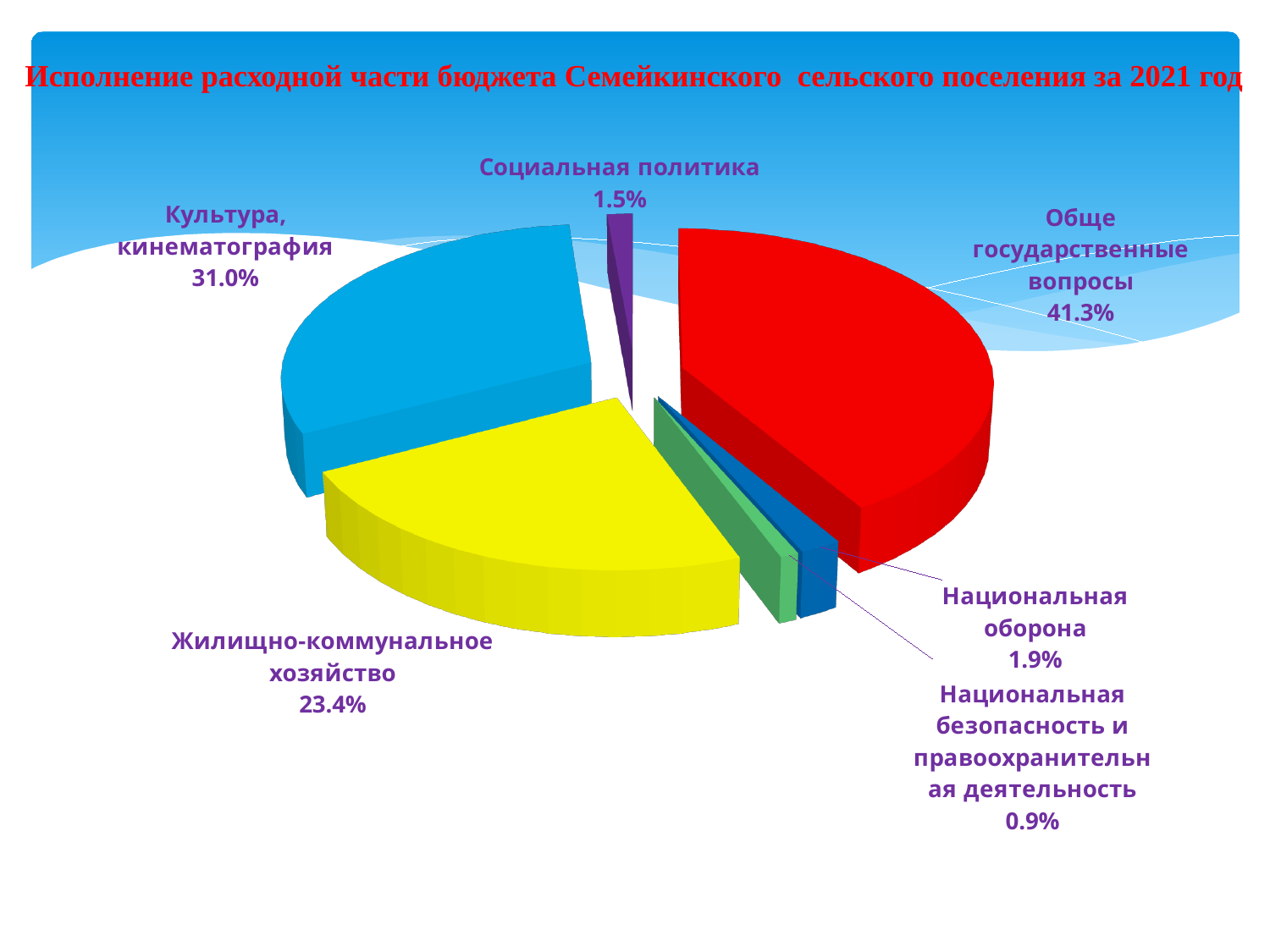
What percentage is shown for Социальная политика? 1.5% What percentage is shown for Культура, кинематография? 31.0% What is the difference in percentage points between Общегосударственные вопросы and Культура, кинематография? 10.3 How many slices does the pie chart have? 6 Which category has the largest share of the pie? Общегосударственные вопросы What is the title of the chart? Исполнение расходной части бюджета Семейкинского сельского поселения за 2021 год What share of the budget expenditure goes to Общегосударственные вопросы? 41.3% What percentage is shown for Жилищно-коммунальное хозяйство? 23.4% What percentage is shown for Национальная оборона? 1.9% Which category has the smallest share of the pie? Национальная безопасность и правоохранительная деятельность What kind of chart is shown on the slide? Pie chart Which is larger: the share for Национальная оборона or the share for Социальная политика? Национальная оборона